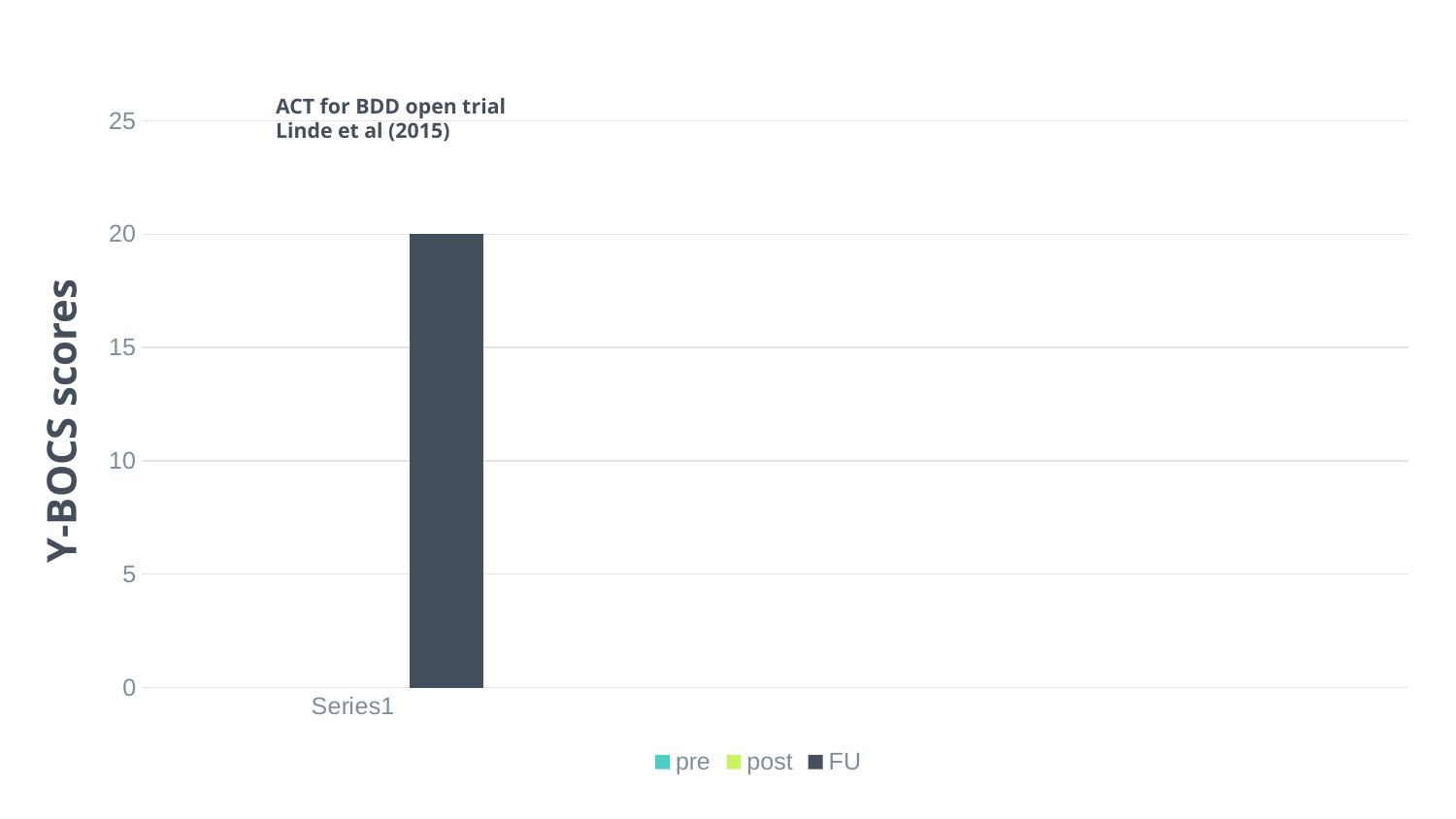
How many categories are shown on the x axis? 1 How many series does the legend list? 3 Is the FU value for Series1 greater or less than 25? less Is the FU value for Series1 greater or less than 15? greater What is the label of the y axis? Y-BOCS scores What kind of chart is shown on the slide? bar chart What is the FU value for Series1? 20 What study is named in the text above the chart? ACT for BDD open trial Linde et al (2015)